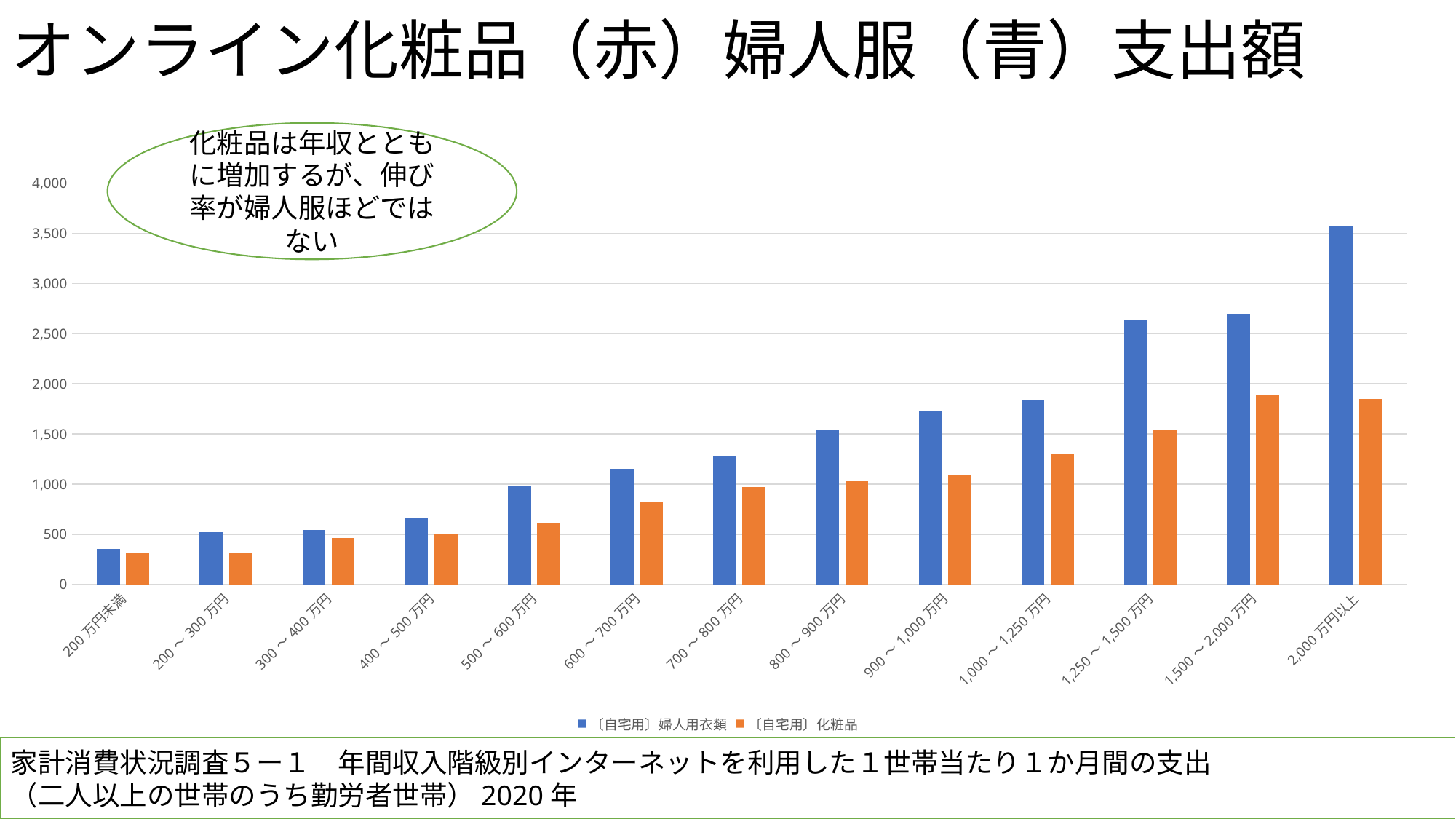
Which income category has the highest value for 〔自宅用〕婦人用衣類? 2,000 万円以上 How many income categories are shown on the x axis? 13 What kind of chart is shown on the slide? Bar chart Is the value for 〔自宅用〕化粧品 in the 2,000 万円以上 category greater or less than 2,000? less Which income category has the lowest value for 〔自宅用〕婦人用衣類? 200 万円未満 Is the value for 〔自宅用〕婦人用衣類 in the 1,250 ～ 1,500 万円 category greater or less than 2,500? greater Which colour represents 〔自宅用〕化粧品 in the chart? Orange Is the value for 〔自宅用〕婦人用衣類 in the 2,000 万円以上 category greater or less than 3,000? greater Do the values for 〔自宅用〕婦人用衣類 generally rise or fall as income increases along the x axis? rise How many series does the legend list? 2 In the 2,000 万円以上 category, which series has the larger value, 〔自宅用〕婦人用衣類 or 〔自宅用〕化粧品? 〔自宅用〕婦人用衣類